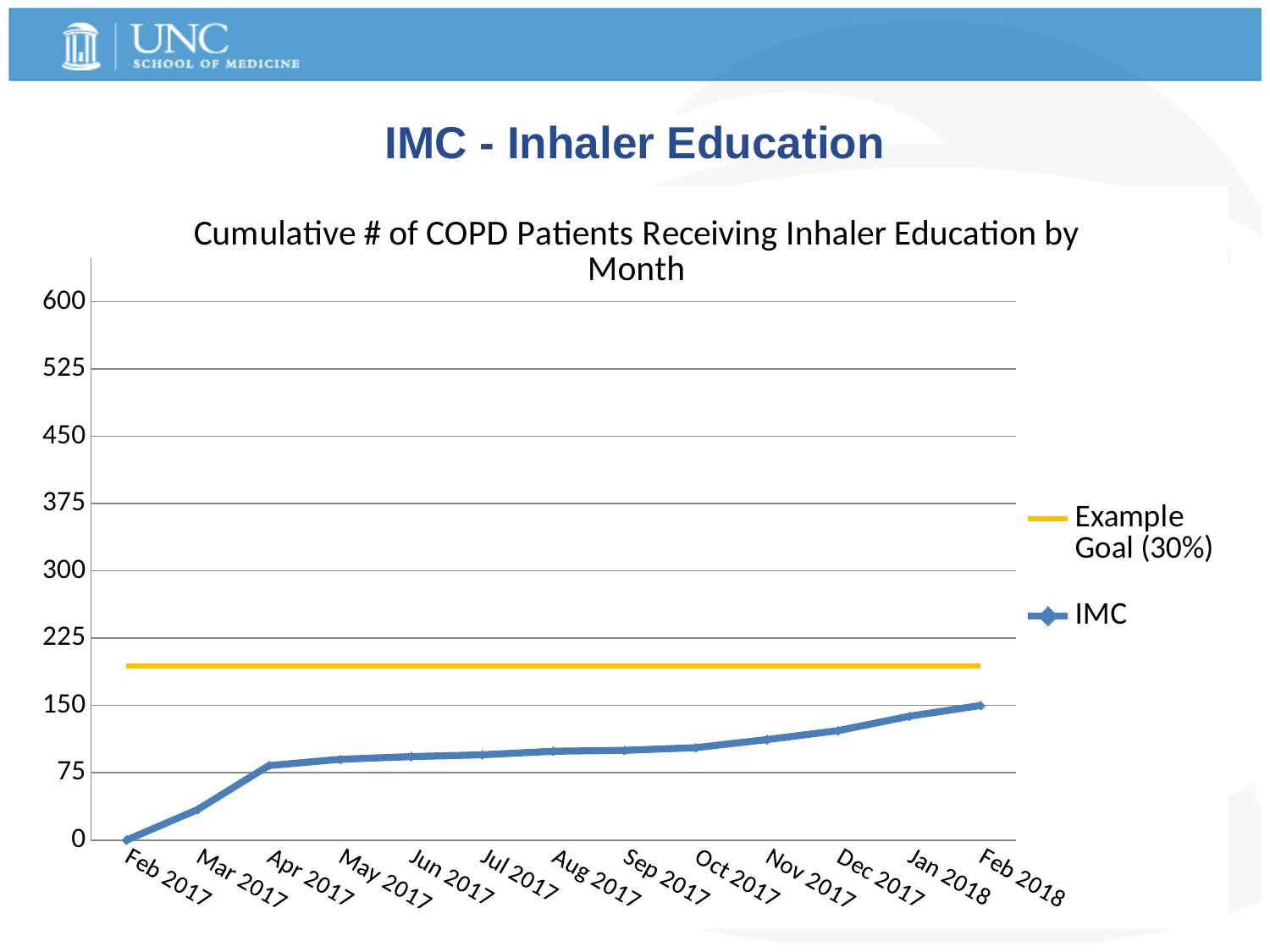
What are the two series named in the legend? Example Goal (30%) and IMC Is the IMC value for Mar 2017 greater or less than 75? less What is the IMC value for Feb 2017? 0 What kind of chart is shown on the slide? line chart In Feb 2018, which is larger: the Example Goal (30%) line or the IMC value? Example Goal (30%) Is the Example Goal (30%) line greater or less than 225? less Does the IMC line rise or fall from Feb 2017 to Feb 2018? rise How many months are shown along the x axis? 13 How many series does the legend list? 2 What is the title of the chart? Cumulative # of COPD Patients Receiving Inhaler Education by Month In which month is the IMC value lowest? Feb 2017 In which month is the IMC value highest? Feb 2018